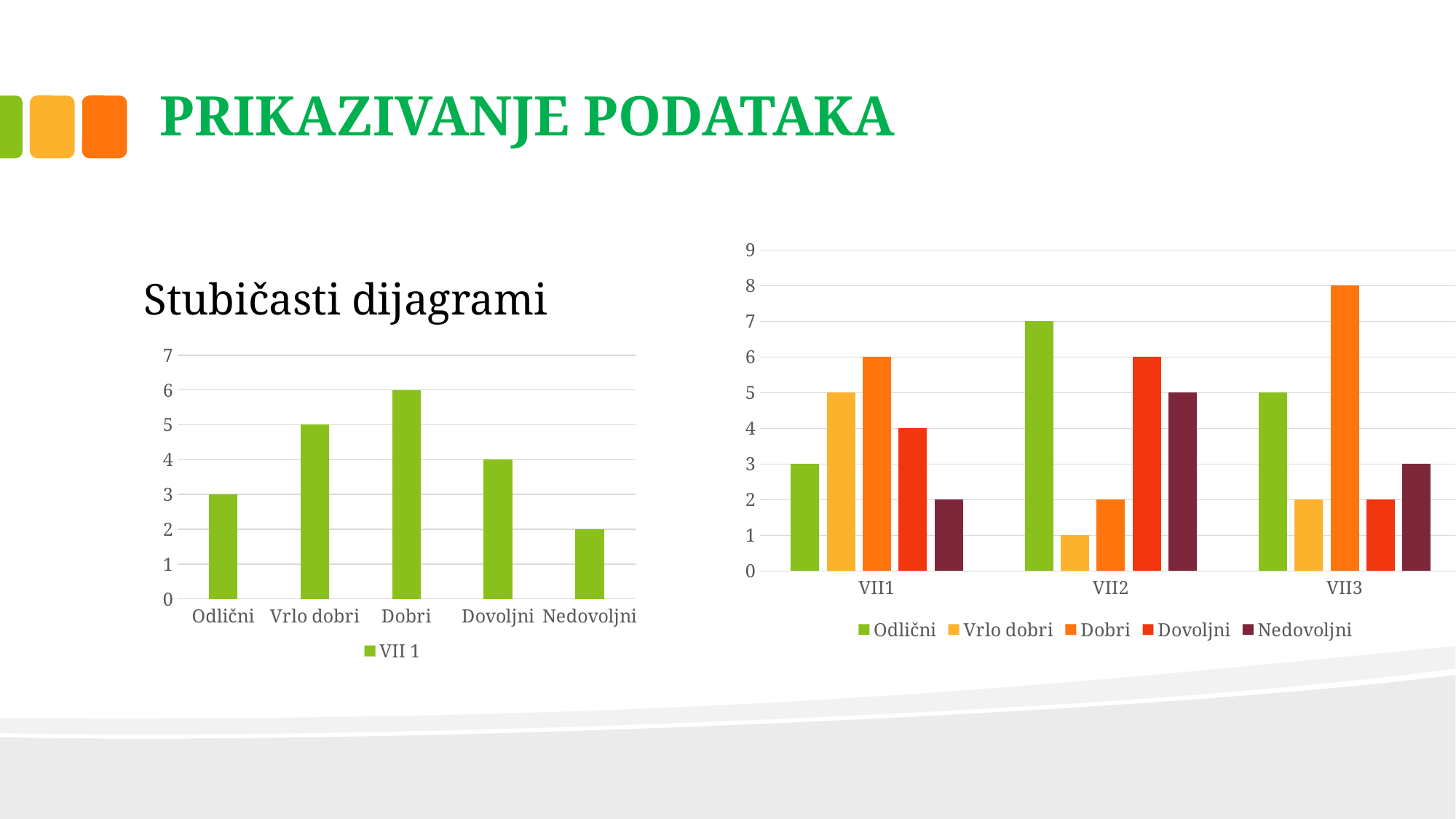
In the left chart, which category has the lowest value? Nedovoljni In the left chart, how many categories are shown on the x axis? 5 In the right chart, what is the value for Odlični in VII2? 7 In the left chart, which category has the highest value? Dobri In the left chart, what is the difference between the values for Vrlo dobri and Odlični? 2 In the right chart, what is the difference between Nedovoljni in VII2 and Nedovoljni in VII1? 3 In the left chart, what series name does the legend show? VII 1 In the left chart, what is the value for Dobri? 6 In the right chart, which is larger: Dovoljni in VII2 or Dovoljni in VII3? Dovoljni in VII2 What type of chart is the right chart? Bar chart In the right chart, how many series does the legend list? 5 In the right chart, what is the value for Dobri in VII3? 8